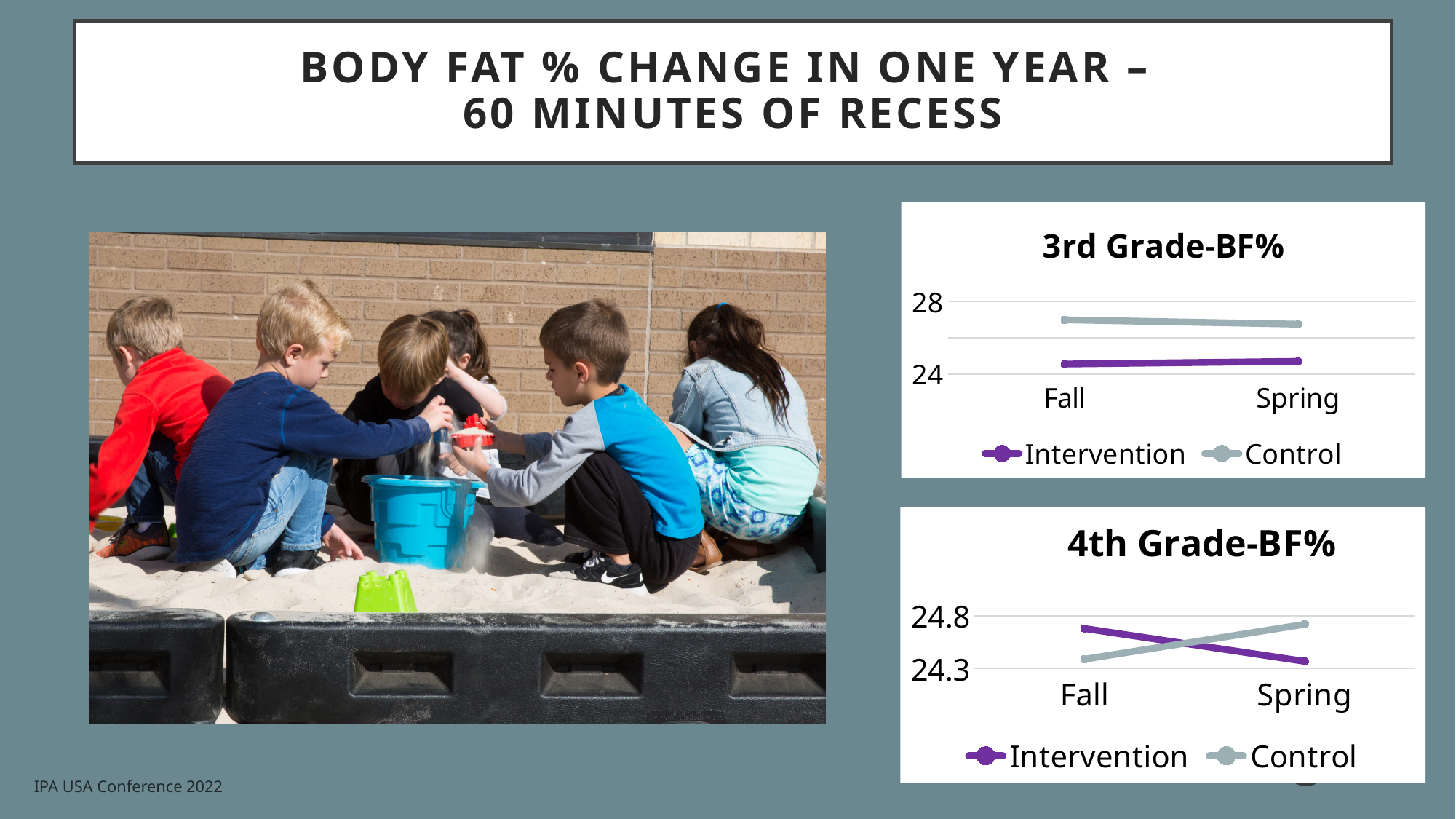
How many points are on the x axis of the 3rd Grade-BF% chart? 2 In the 3rd Grade-BF% chart, is the Control value at Fall greater or less than 28? less In the 4th Grade-BF% chart, does the Intervention line rise or fall from Fall to Spring? fall In the 3rd Grade-BF% chart, does the Control line rise or fall from Fall to Spring? fall In the 3rd Grade-BF% chart, is the Intervention value at Spring greater or less than 24? greater How many series does the legend of the 4th Grade-BF% chart list? 2 In the 3rd Grade-BF% chart, which series is higher at Fall, Intervention or Control? Control What kind of chart is the 3rd Grade-BF% chart? line chart In the 4th Grade-BF% chart, does the Control line rise or fall from Fall to Spring? rise In the 4th Grade-BF% chart, which series is higher at Fall, Intervention or Control? Intervention What are the two x-axis labels on the 4th Grade-BF% chart? Fall and Spring In the 4th Grade-BF% chart, which series is higher at Spring, Intervention or Control? Control